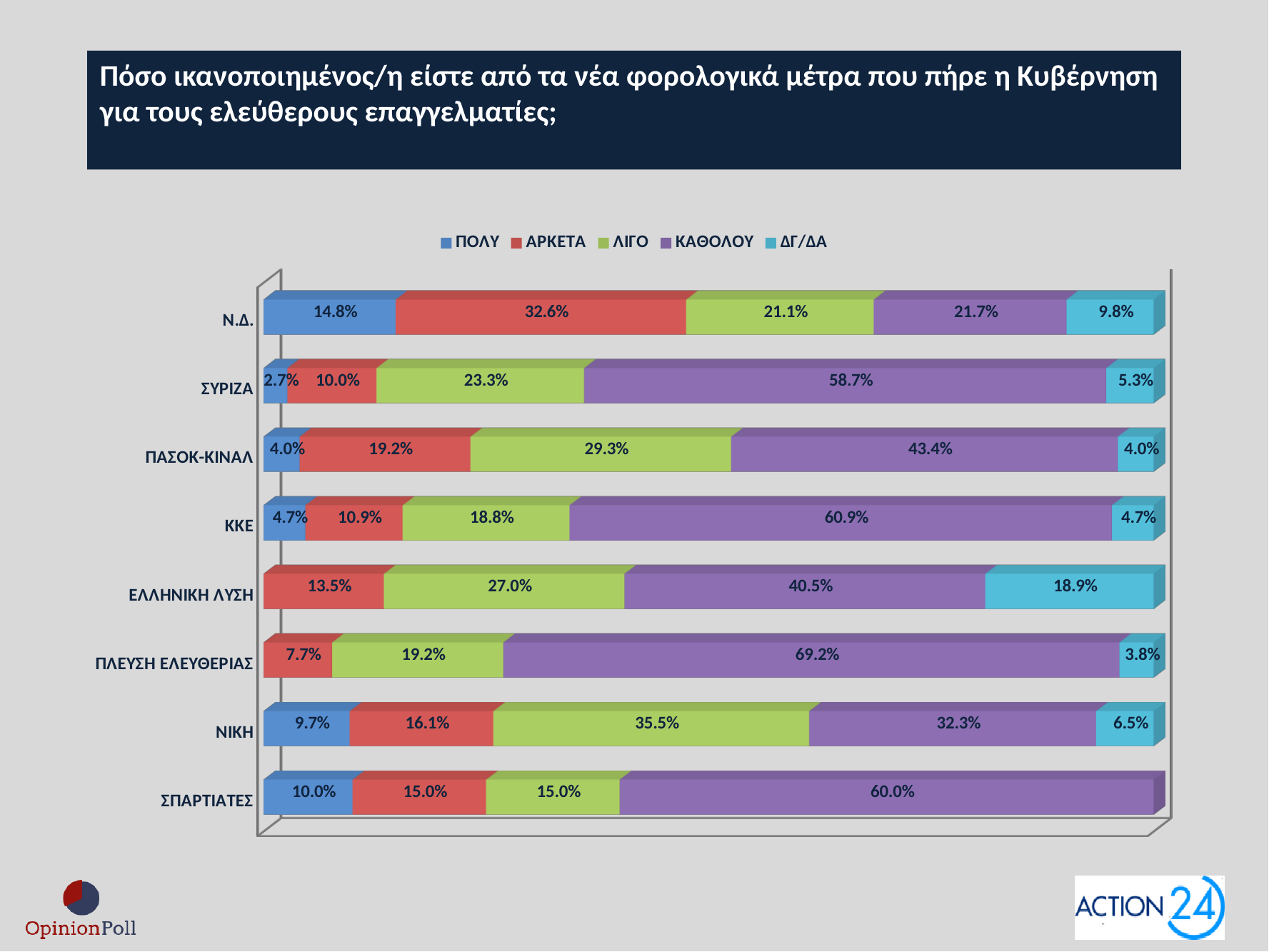
What is the total of the labelled segments in the ΣΠΑΡΤΙΑΤΕΣ bar? 100.0% Which is larger: the ΚΑΘΟΛΟΥ value for ΚΚΕ or for ΣΥΡΙΖΑ? ΚΚΕ What is the ΔΓ/ΔΑ value for ΕΛΛΗΝΙΚΗ ΛΥΣΗ? 18.9% How many parties (categories) are shown on the chart? 8 How many series does the legend list? 5 Which party has the lowest ΚΑΘΟΛΟΥ value? Ν.Δ. Which party has the highest ΠΟΛΥ value? Ν.Δ. What kind of chart is shown on the slide? Stacked bar chart What is the ΑΡΚΕΤΑ value for Ν.Δ.? 32.6% Which party has the highest ΚΑΘΟΛΟΥ value? ΠΛΕΥΣΗ ΕΛΕΥΘΕΡΙΑΣ What is the ΚΑΘΟΛΟΥ value for ΣΥΡΙΖΑ? 58.7% What is the difference between the ΑΡΚΕΤΑ and ΠΟΛΥ values for Ν.Δ.? 17.8 percentage points